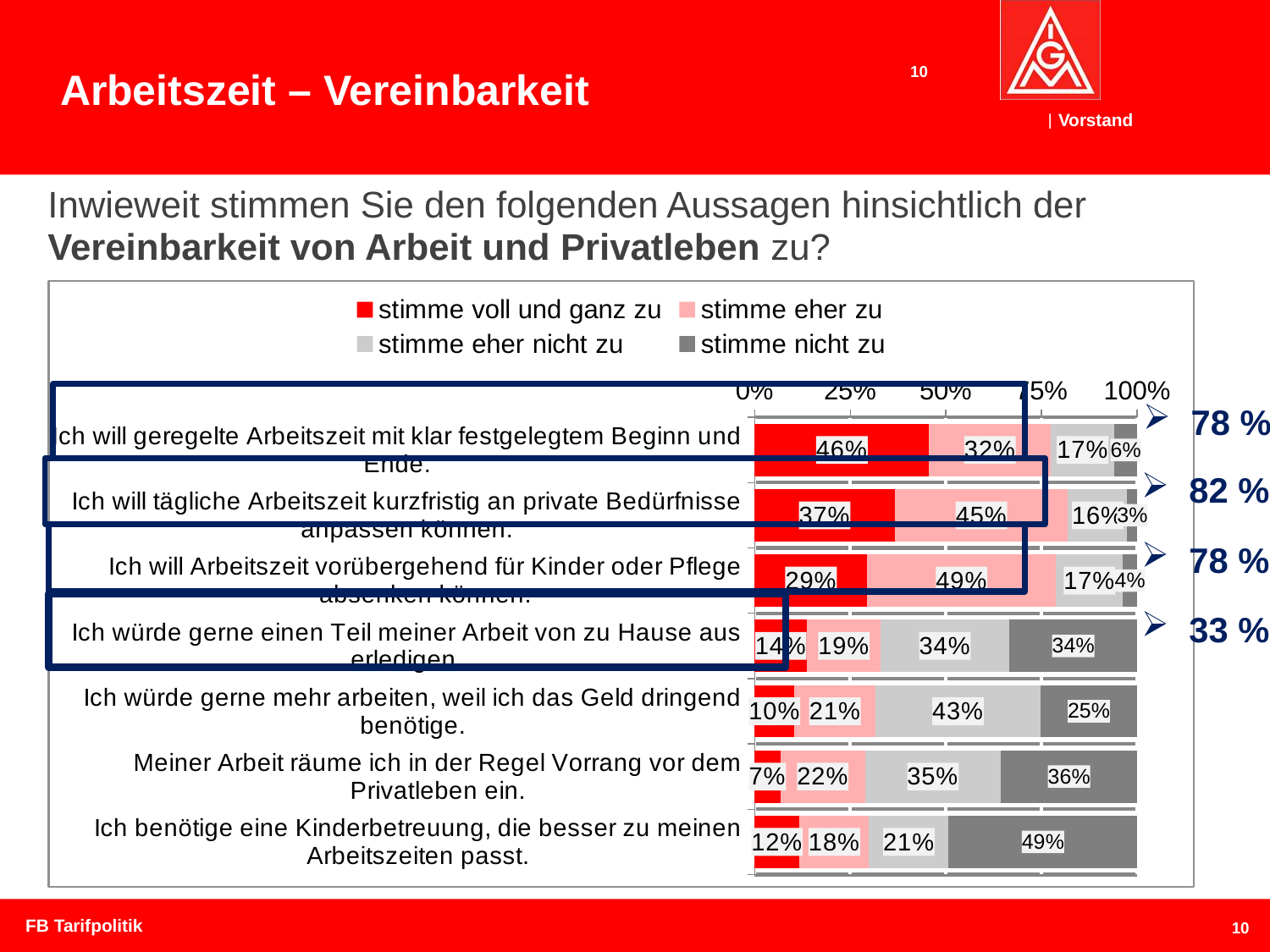
Which is larger: the "stimme eher zu" value for "Ich will tägliche Arbeitszeit kurzfristig an private Bedürfnisse anpassen können." or for "Ich will geregelte Arbeitszeit mit klar festgelegtem Beginn und Ende."? Ich will tägliche Arbeitszeit kurzfristig an private Bedürfnisse anpassen können. Which statement has the lowest "stimme voll und ganz zu" value? Meiner Arbeit räume ich in der Regel Vorrang vor dem Privatleben ein. What kind of chart is shown on the slide? stacked bar chart What is the combined total of "stimme voll und ganz zu" and "stimme eher zu" for "Ich würde gerne einen Teil meiner Arbeit von zu Hause aus erledigen."? 33% Which colour represents "stimme nicht zu" in the legend? dark grey What is the "stimme nicht zu" value for "Ich benötige eine Kinderbetreuung, die besser zu meinen Arbeitszeiten passt."? 49% How many series does the legend list? 4 How many statements (categories) are plotted in the chart? 7 Which statement has the highest "stimme voll und ganz zu" value? Ich will geregelte Arbeitszeit mit klar festgelegtem Beginn und Ende. What is the difference between the "stimme eher nicht zu" value for "Ich würde gerne mehr arbeiten, weil ich das Geld dringend benötige." and for "Ich benötige eine Kinderbetreuung, die besser zu meinen Arbeitszeiten passt."? 22% What is the "stimme eher zu" value for "Ich will Arbeitszeit vorübergehend für Kinder oder Pflege absenken können."? 49% What is the "stimme voll und ganz zu" value for "Ich will geregelte Arbeitszeit mit klar festgelegtem Beginn und Ende."? 46%